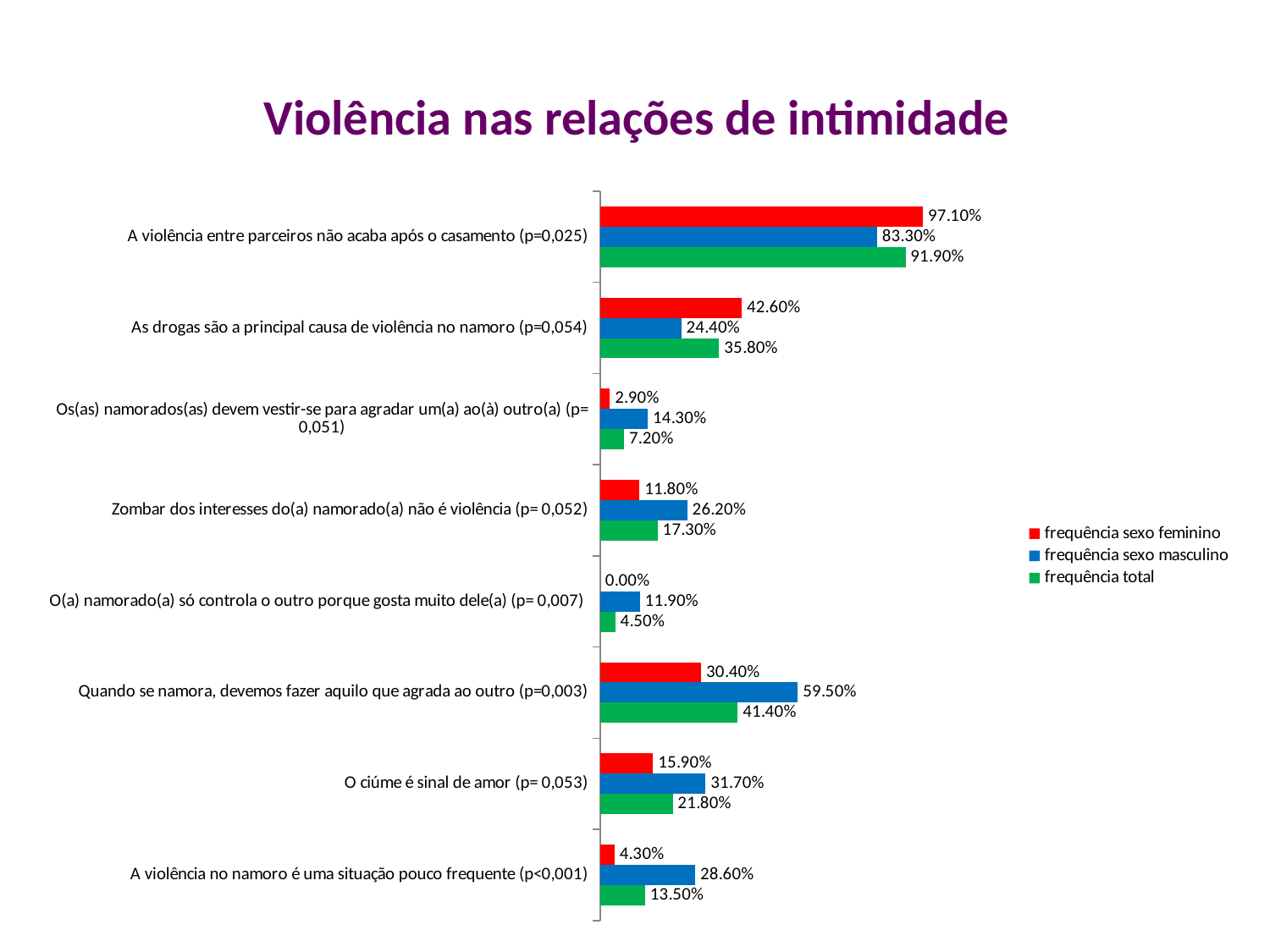
What is the 'frequência sexo masculino' value for 'Quando se namora, devemos fazer aquilo que agrada ao outro'? 59.50% What kind of chart is shown on the slide? Bar chart Which statement has the highest 'frequência total' value? A violência entre parceiros não acaba após o casamento What is the 'frequência sexo feminino' value for 'O(a) namorado(a) só controla o outro porque gosta muito dele(a)'? 0.00% What is the 'frequência total' value for 'O ciúme é sinal de amor'? 21.80% For 'As drogas são a principal causa de violência no namoro', which is larger: 'frequência sexo feminino' or 'frequência sexo masculino'? frequência sexo feminino How many series does the legend list? 3 Which colour represents 'frequência total' in the chart? Green What is the difference between the 'frequência sexo masculino' and 'frequência sexo feminino' values for 'A violência no namoro é uma situação pouco frequente'? 24.30% What is the 'frequência sexo feminino' value for 'A violência entre parceiros não acaba após o casamento'? 97.10% Which statement has the lowest 'frequência sexo masculino' value? O(a) namorado(a) só controla o outro porque gosta muito dele(a) How many statements (categories) are shown in the chart? 8